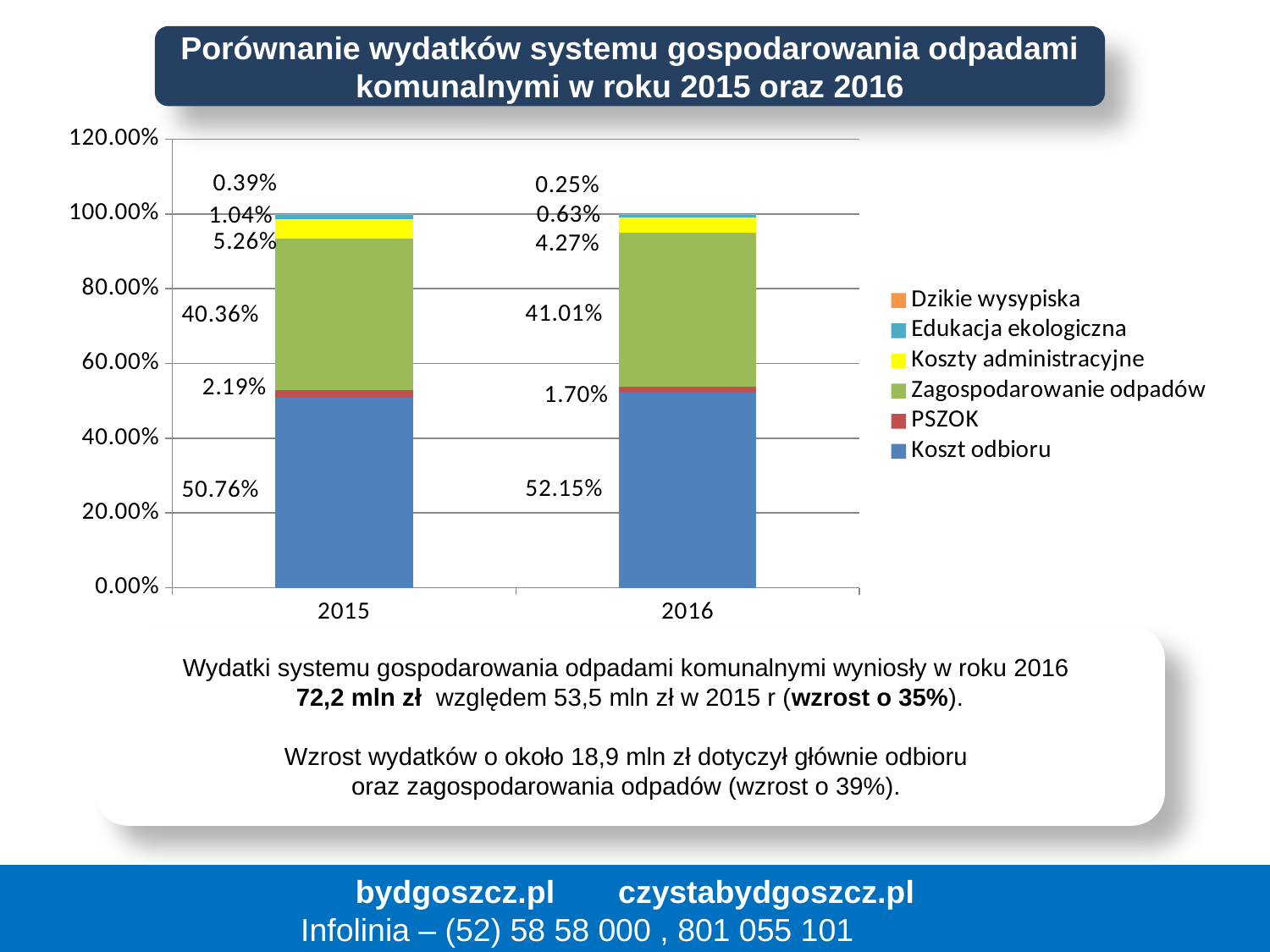
What is the value for Dzikie wysypiska in 2016? 0.25% By how many percentage points did Koszt odbioru change from 2015 to 2016? 1.39 percentage points What is the value for Koszt odbioru in 2015? 50.76% What is the value for PSZOK in 2016? 1.70% What kind of chart is shown on the slide? Stacked bar chart Which series has the smallest share in 2015? Dzikie wysypiska What is the value for Zagospodarowanie odpadów in 2016? 41.01% What is the total of the stacked bar for 2015? 100.00% How many series does the legend list? 6 What is the value for Koszty administracyjne in 2015? 5.26% Is the value for Koszty administracyjne larger in 2015 or in 2016? 2015 Which series has the largest share in 2016? Koszt odbioru